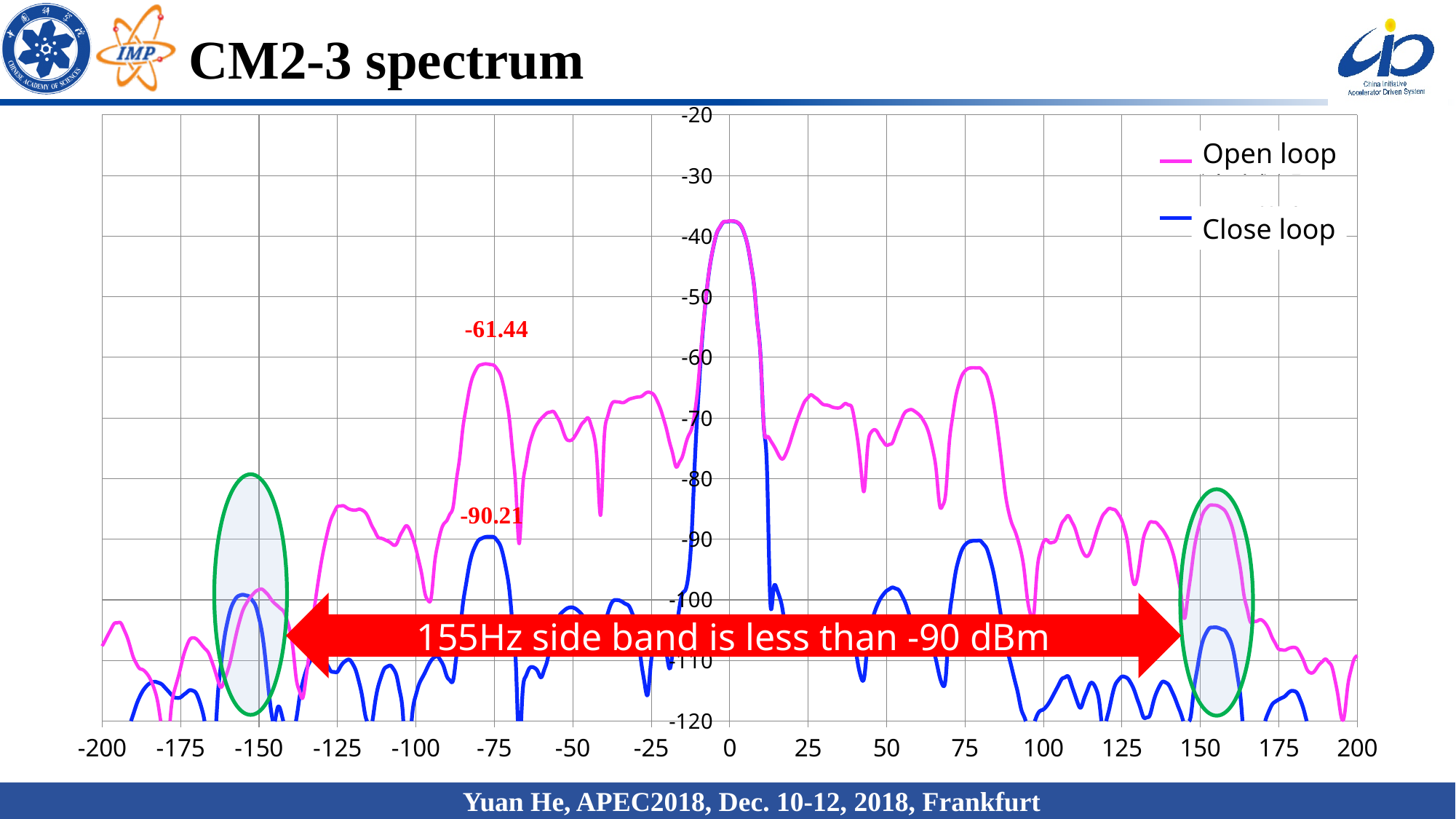
Which is higher for the Open loop series: the peak at 0 Hz or the peak near -75 Hz? the peak at 0 Hz What kind of chart is shown on the slide? line chart Is the Close loop value at the 155 Hz side band greater or less than -100? less What is the title of the chart? CM2-3 spectrum What value is labelled on the Open loop peak near -75 Hz? -61.44 What is the difference between the labelled Open loop peak (-61.44) and the labelled Close loop peak (-90.21) near -75 Hz? 28.77 How many series does the legend list? 2 Is the Open loop value at 0 Hz greater or less than -50? greater What does the red arrow annotation on the chart say? 155Hz side band is less than -90 dBm Is the Open loop value at the 155 Hz side band greater or less than -90? greater Near -75 Hz, which series has the higher value, Open loop or Close loop? Open loop What value is labelled on the Close loop peak near -75 Hz? -90.21